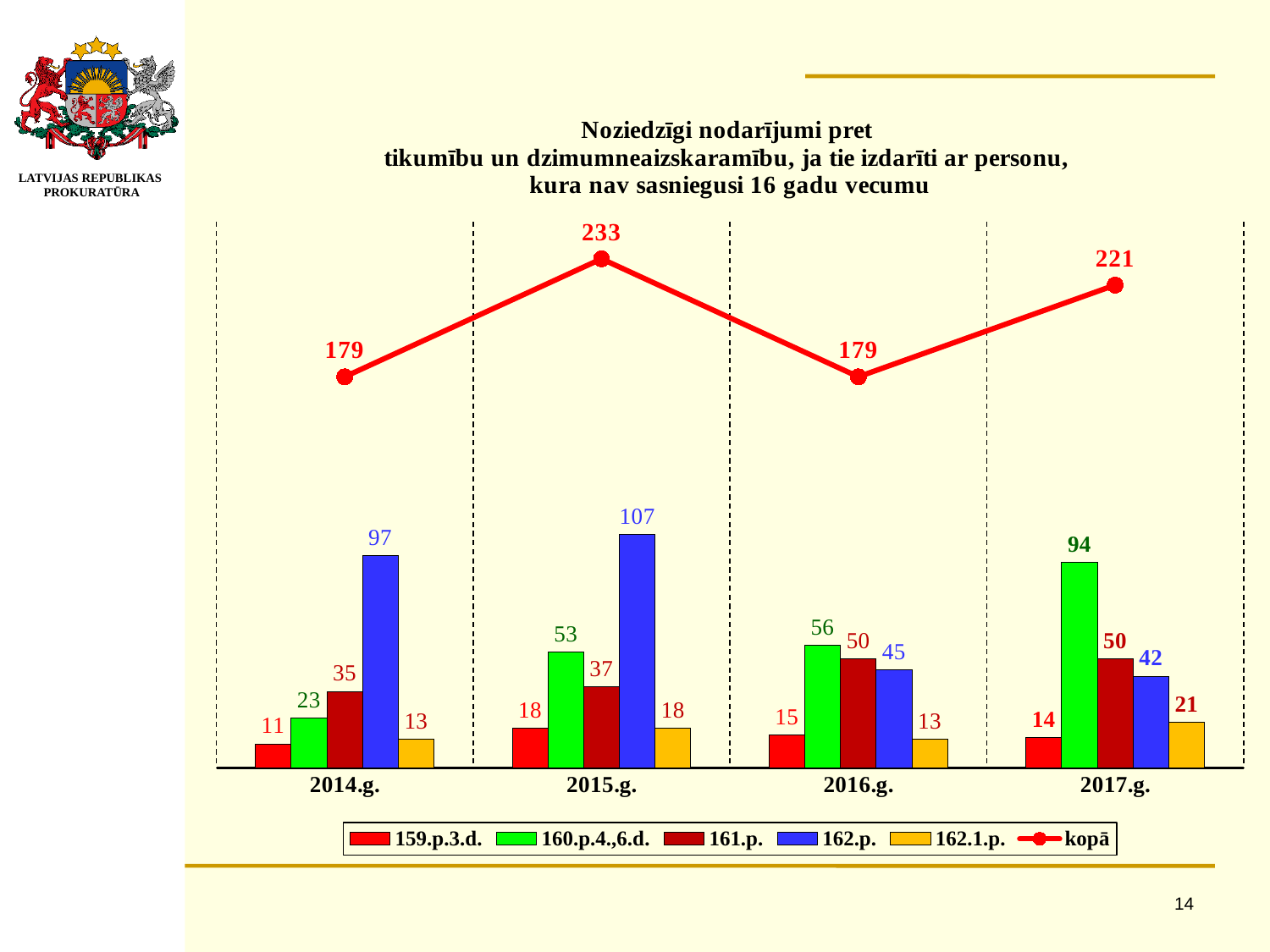
What is the value of the kopā line for 2015.g.? 233 Which series has the lowest value in 2016.g.? 162.1.p. How many years are shown on the x axis? 4 What kind of chart is this? Combined bar and line chart How many series does the legend list? 6 Which is larger in 2017.g.: the value for 161.p. or the value for 162.p.? 161.p. What is the value for series 160.p.4.,6.d. in 2017.g.? 94 What is the value for series 159.p.3.d. in 2014.g.? 11 Does the value for series 160.p.4.,6.d. rise or fall from 2014.g. to 2017.g.? Rise In which year does the kopā line reach its highest value? 2015.g. What is the value for series 162.p. in 2015.g.? 107 What is the difference between the kopā values for 2015.g. and 2016.g.? 54